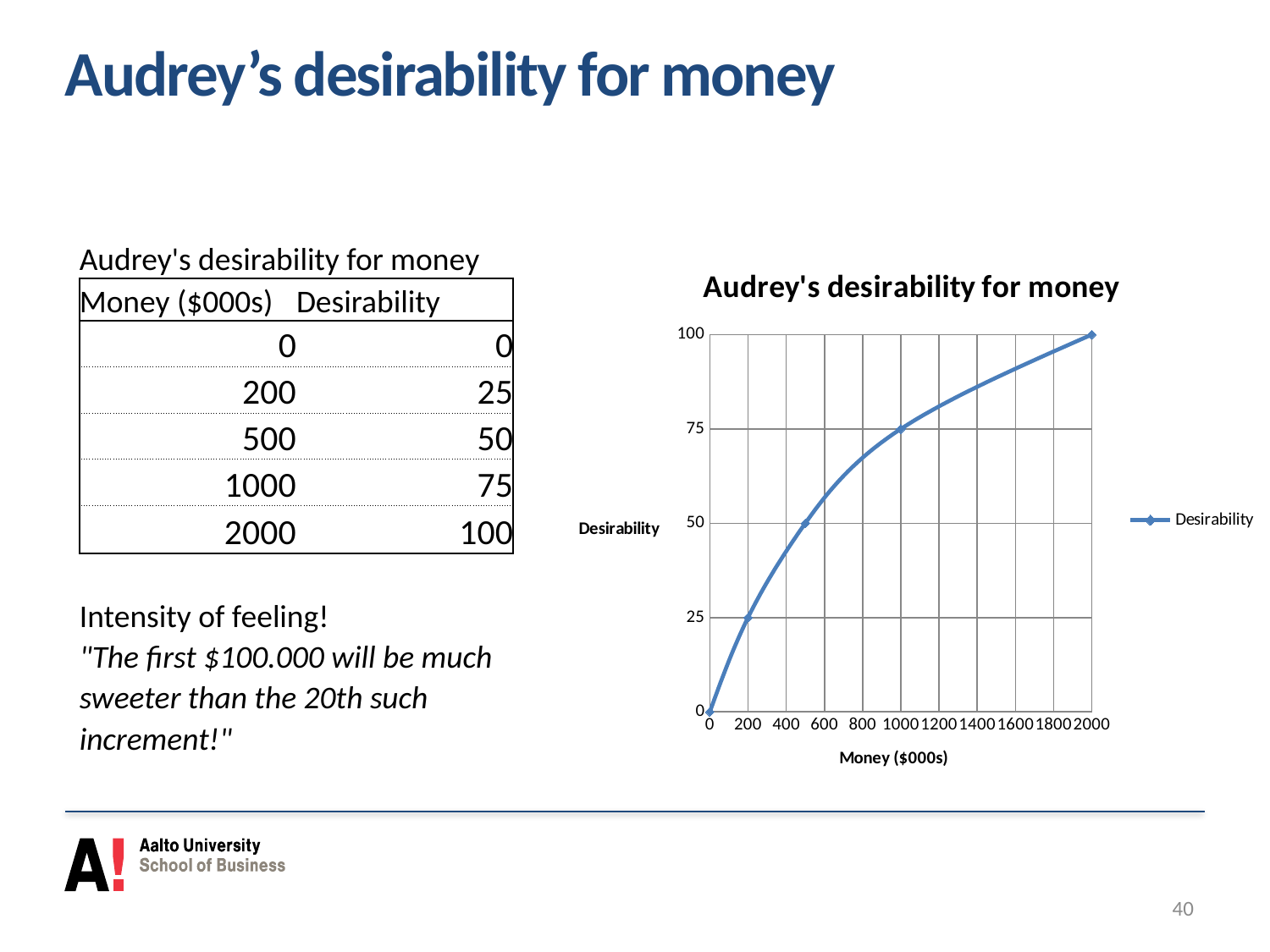
What is the desirability value when money is 200 ($000s)? 25 Does desirability rise or fall as money increases along the x axis? rise What type of chart is shown on the slide? line chart What is the label of the x axis? Money ($000s) What is the title of the chart? Audrey's desirability for money What is the desirability value when money is 1000 ($000s)? 75 How many series does the chart legend list? 1 At which money value is desirability lowest? 0 What is the difference in desirability between money of 1000 and money of 200 ($000s)? 50 What is the desirability value when money is 2000 ($000s)? 100 How many data points are plotted on the Desirability line? 5 At which money value is desirability highest? 2000